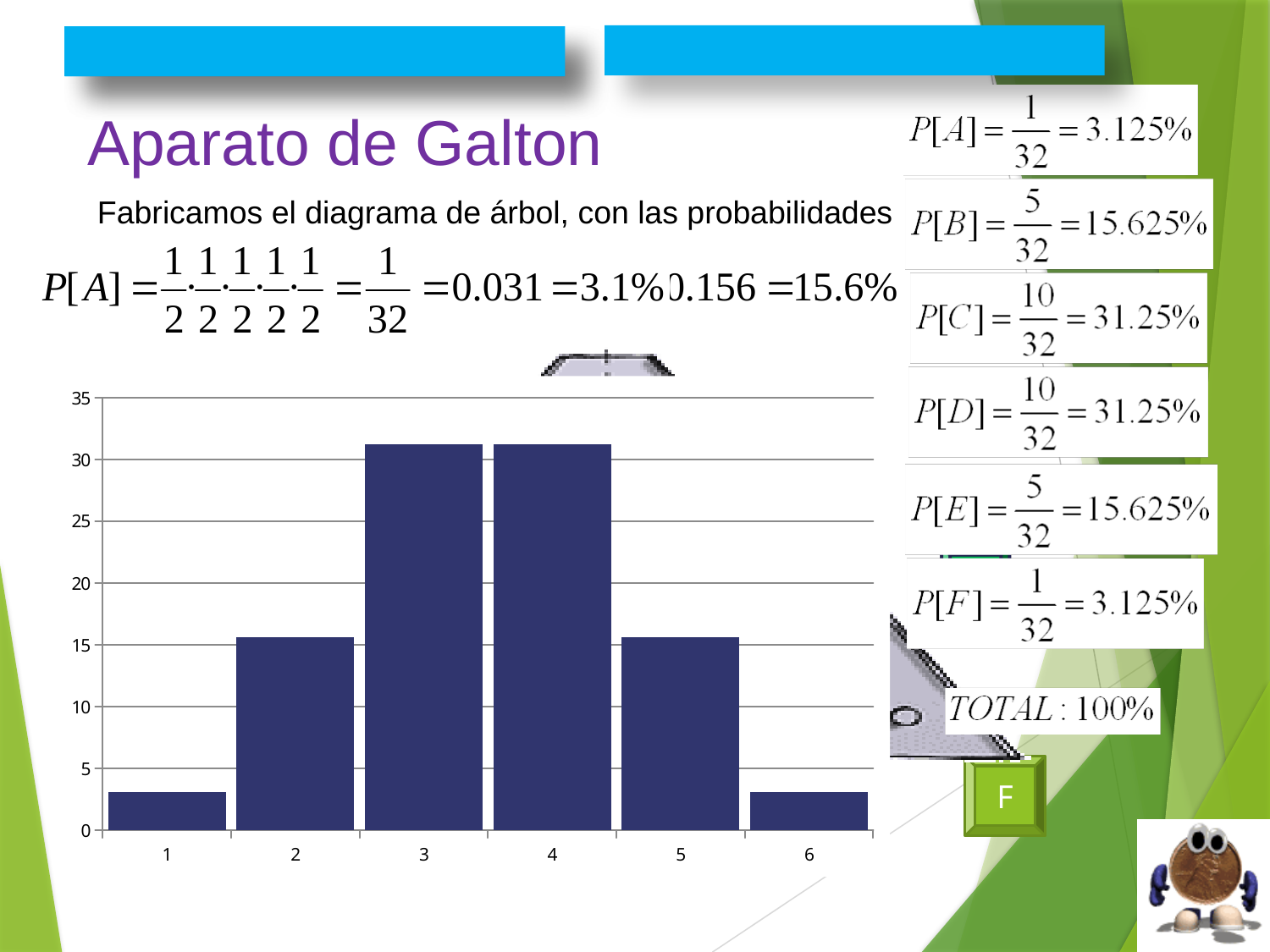
Is the value for category 4 greater or less than 35? less How many categories are shown on the x axis of the bar chart? 6 What kind of chart is shown on the slide? bar chart Is the value for category 6 greater or less than 5? less Is the value for category 1 greater or less than 5? less What is the highest value shown on the y axis of the bar chart? 35 Which is larger, the value for category 3 or the value for category 2? category 3 Which is larger, the value for category 5 or the value for category 6? category 5 Do the values rise or fall from category 1 to category 3? rise